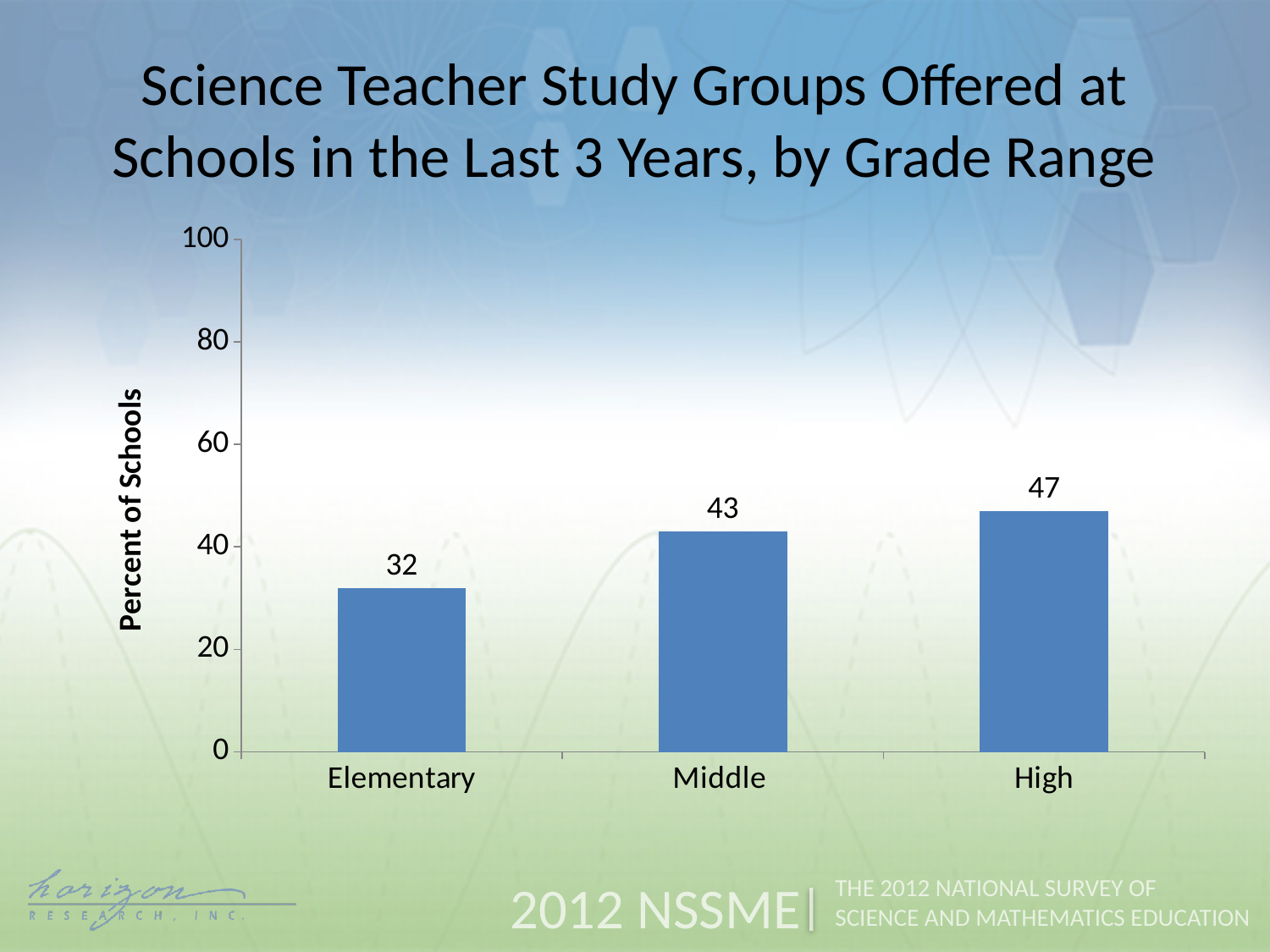
Which grade range has the lowest percent of schools? Elementary What is the difference between the values for High and Elementary schools? 15 What is the value for Middle schools? 43 Do the values rise or fall from Elementary to High? Rise How many grade ranges are shown on the chart? 3 Is the value for High greater or less than 40? greater What is the difference between the values for Middle and Elementary schools? 11 Which is larger, the value for Middle or the value for Elementary? Middle What percent of elementary schools offered science teacher study groups in the last 3 years? 32 What is the value for High schools? 47 What kind of chart is shown on the slide? Bar chart Which grade range has the highest percent of schools? High